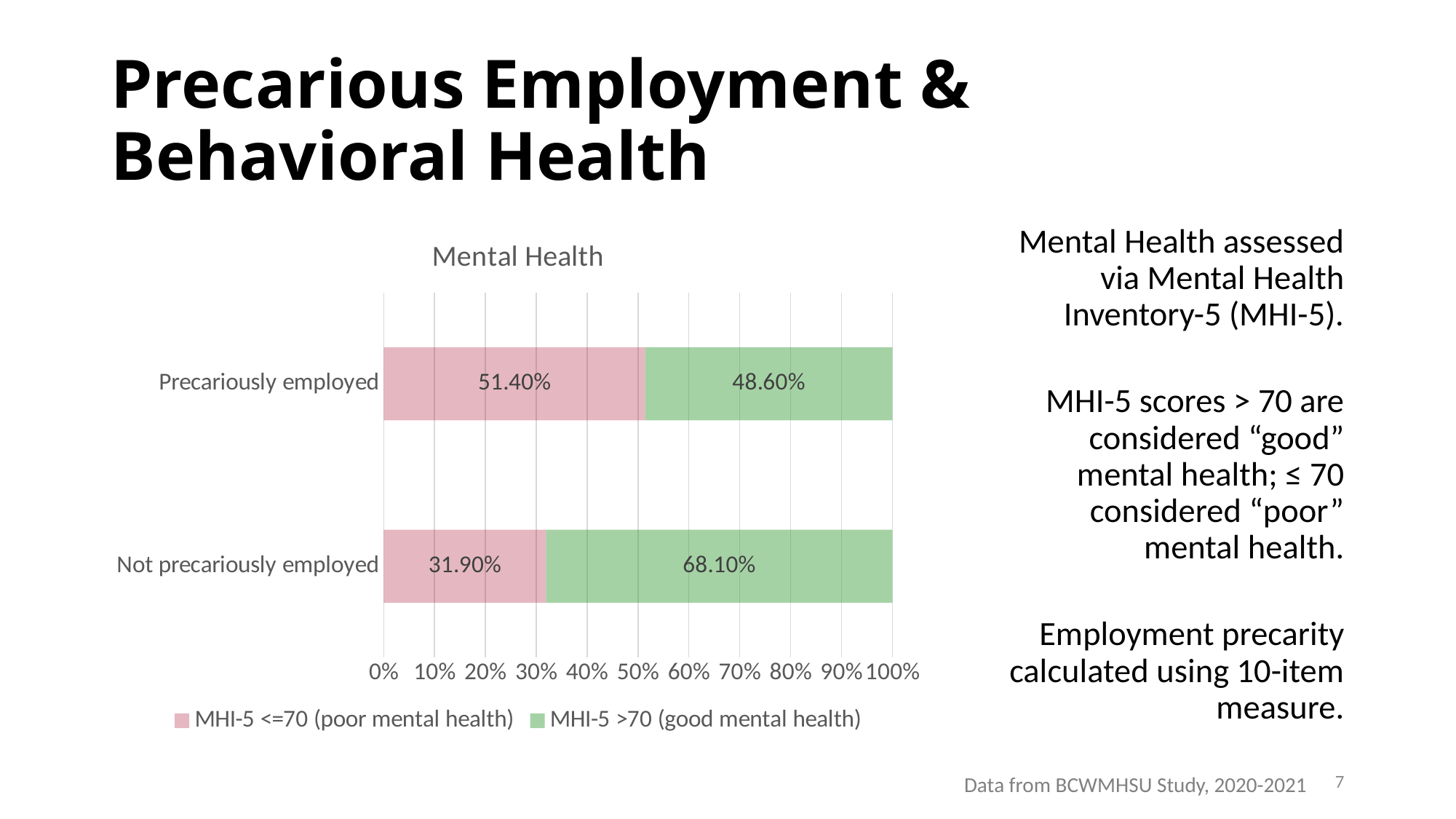
What is the value for MHI-5 <=70 (poor mental health) for the Precariously employed group? 51.40% How many employment groups are shown on the chart? 2 Which group has the higher share of MHI-5 <=70 (poor mental health)? Precariously employed What kind of chart is shown on the slide? Stacked bar chart What is the total of the stacked bar for the Precariously employed group? 100% What is the value for MHI-5 >70 (good mental health) for the Not precariously employed group? 68.10% How many series does the legend list? 2 Which group has the lower share of MHI-5 >70 (good mental health)? Precariously employed What is the value for MHI-5 <=70 (poor mental health) for the Not precariously employed group? 31.90% What is the difference in the MHI-5 <=70 (poor mental health) share between the Precariously employed and Not precariously employed groups? 19.50% What is the value for MHI-5 >70 (good mental health) for the Precariously employed group? 48.60% Is the MHI-5 >70 (good mental health) value larger for the Precariously employed or the Not precariously employed group? Not precariously employed